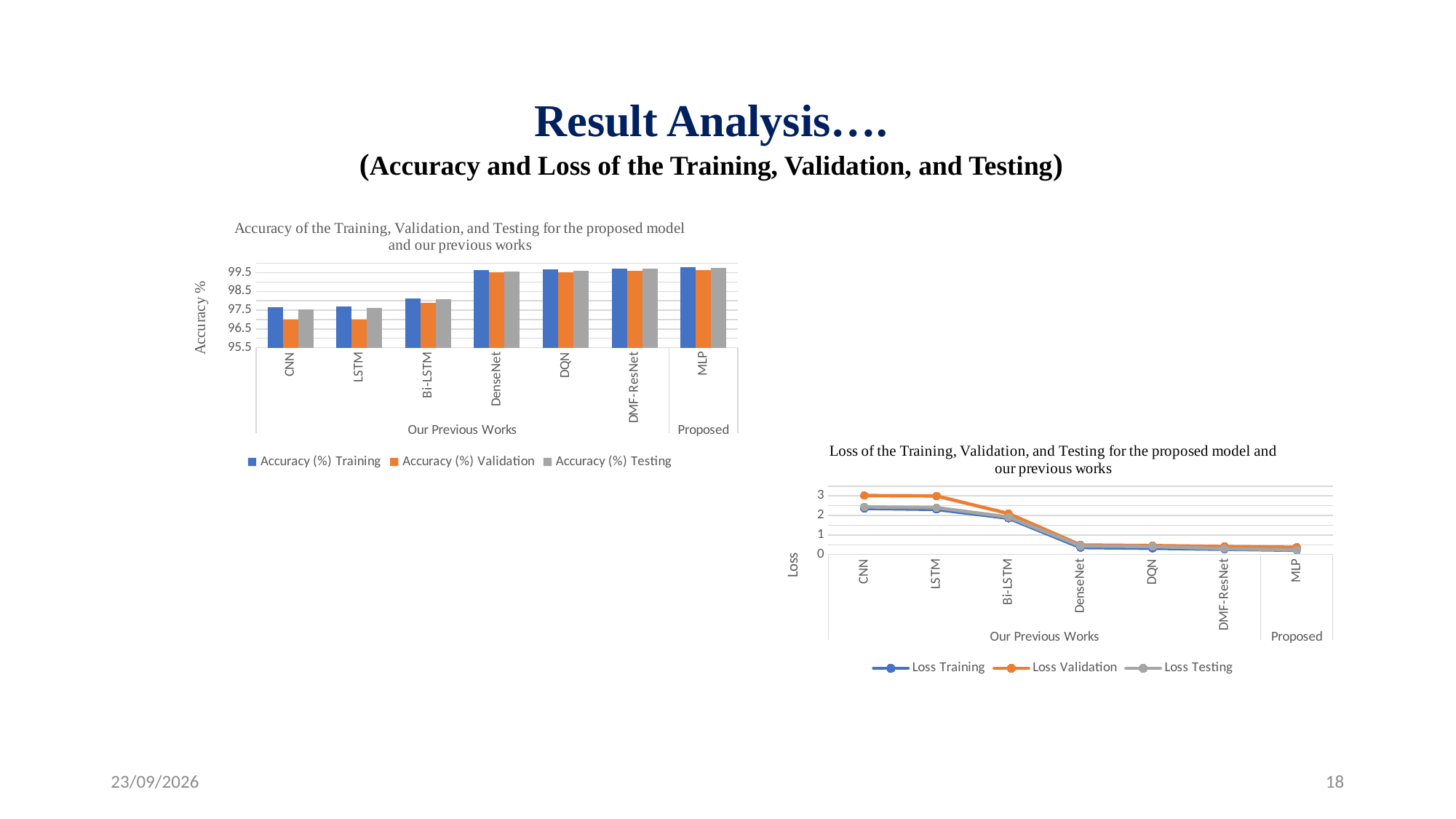
In the loss line chart on the right, is the Loss Training value for CNN greater or less than 2? greater In the accuracy bar chart on the left, which model is labelled under the 'Proposed' group on the x axis? MLP In the loss line chart on the right, do the loss values rise or fall moving from CNN to MLP along the x axis? fall In the loss line chart on the right, which is larger for CNN: Loss Validation or Loss Training? Loss Validation What kind of chart is the 'Loss of the Training, Validation, and Testing' chart on the right? line chart In the accuracy bar chart on the left, is the Accuracy (%) Training value for DenseNet greater or less than 98.5? greater What kind of chart is the 'Accuracy of the Training, Validation, and Testing' chart on the left? bar chart In the accuracy bar chart on the left, is the Accuracy (%) Validation value for CNN greater or less than 97.5? less In the accuracy bar chart on the left, which is larger for CNN: Accuracy (%) Training or Accuracy (%) Validation? Accuracy (%) Training In the loss line chart on the right, how many series does the legend list? 3 In the accuracy bar chart on the left, how many models are shown on the x axis? 7